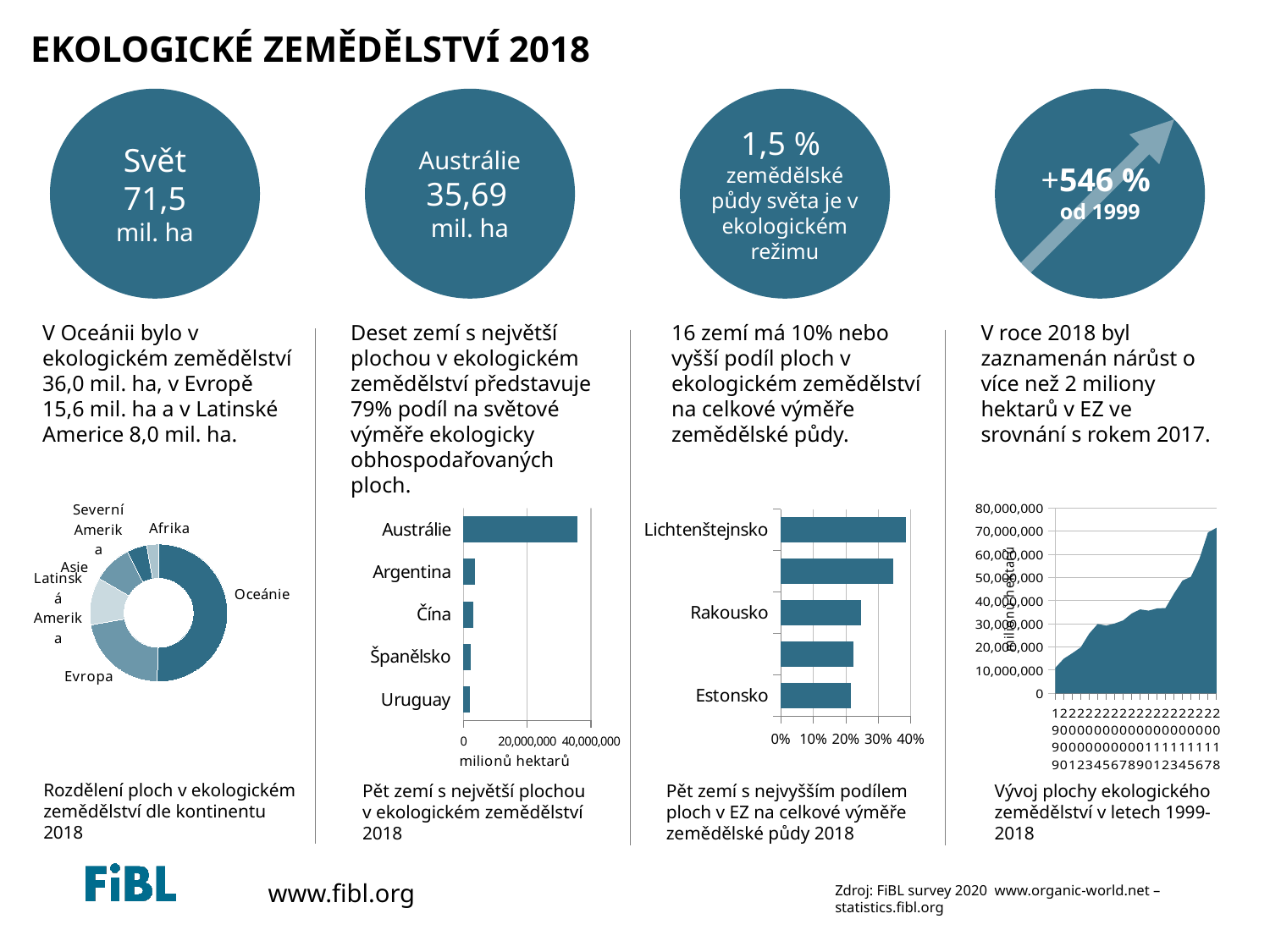
In the chart 'Vývoj plochy ekologického zemědělství v letech 1999-2018', is the value for 2018 greater or less than 60,000,000? greater In the chart 'Vývoj plochy ekologického zemědělství v letech 1999-2018', do the values rise or fall over time? Rise How many continents are shown in the chart 'Rozdělení ploch v ekologickém zemědělství dle kontinentu 2018'? 6 In the chart 'Pět zemí s největší plochou v ekologickém zemědělství 2018', is the value for Argentina greater or less than 20,000,000? less In the chart 'Rozdělení ploch v ekologickém zemědělství dle kontinentu 2018', which continent has the largest share? Oceánie In the chart 'Pět zemí s nejvyšším podílem ploch v EZ na celkové výměře zemědělské půdy 2018', which is larger, Lichtenštejnsko or Rakousko? Lichtenštejnsko What kind of chart is 'Pět zemí s největší plochou v ekologickém zemědělství 2018'? Bar chart What kind of chart is 'Rozdělení ploch v ekologickém zemědělství dle kontinentu 2018'? Doughnut (pie) chart In the chart 'Pět zemí s nejvyšším podílem ploch v EZ na celkové výměře zemědělské půdy 2018', is the value for Rakousko greater or less than 20%? greater In the chart 'Pět zemí s nejvyšším podílem ploch v EZ na celkové výměře zemědělské půdy 2018', which country has the highest share? Lichtenštejnsko In the chart 'Pět zemí s největší plochou v ekologickém zemědělství 2018', which country has the largest area? Austrálie